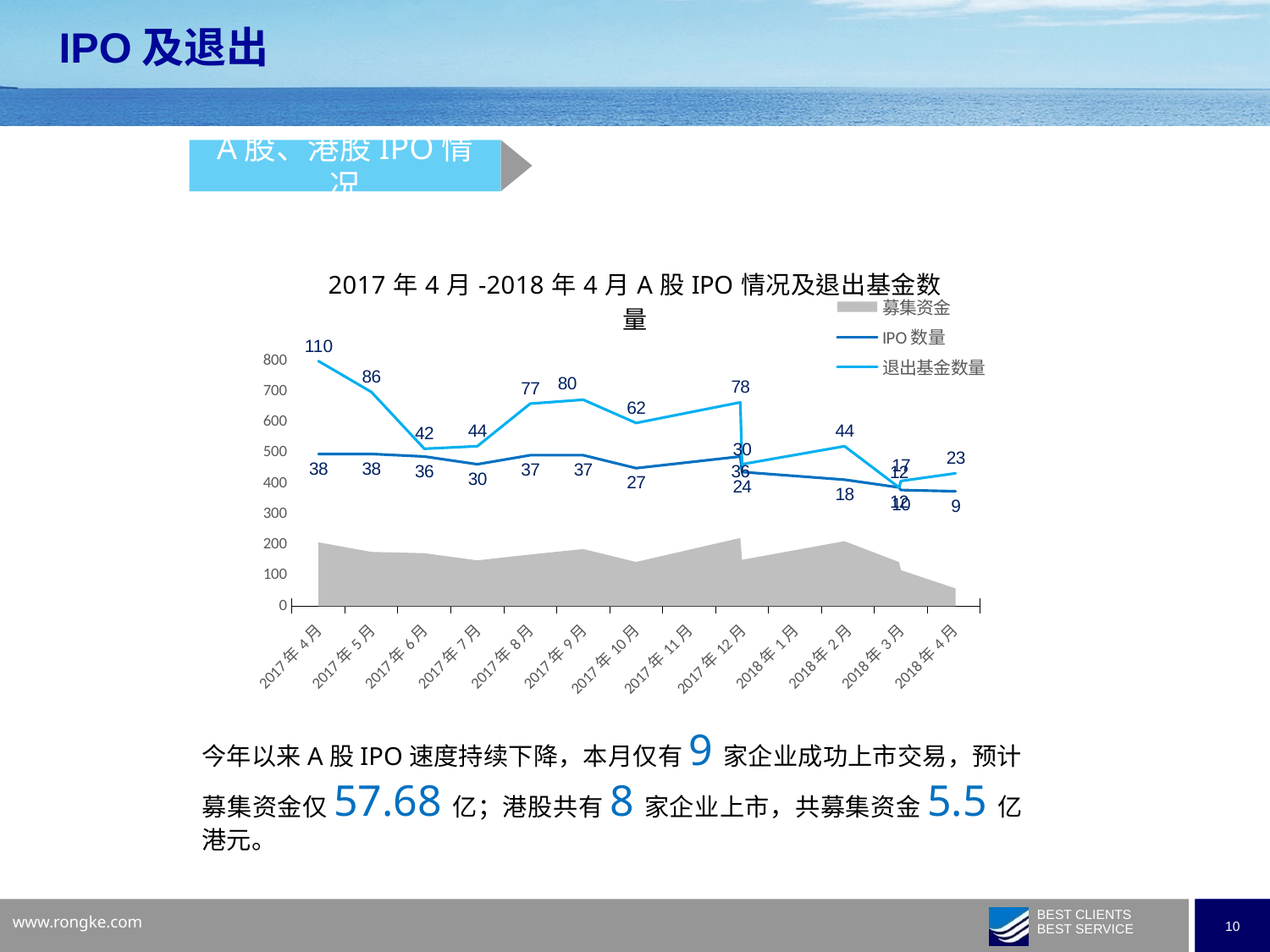
What is the IPO 数量 value for 2018年4月? 9 Does the IPO 数量 series generally rise or fall from 2017年4月 to 2018年4月? fall How many series does the legend list? 3 In which month is the IPO 数量 series lowest? 2018年4月 How many months are shown on the x axis? 13 What is the difference between the 退出基金数量 values for 2017年4月 and 2017年5月? 24 In which month is the 退出基金数量 series highest? 2017年4月 What is the 退出基金数量 value for 2017年4月? 110 What is the IPO 数量 value for 2017年10月? 27 What is the 退出基金数量 value for 2017年9月? 80 Which is larger, the 退出基金数量 value for 2017年8月 or for 2017年10月? 2017年8月 Is the 募集资金 value for 2018年4月 greater or less than 100? less